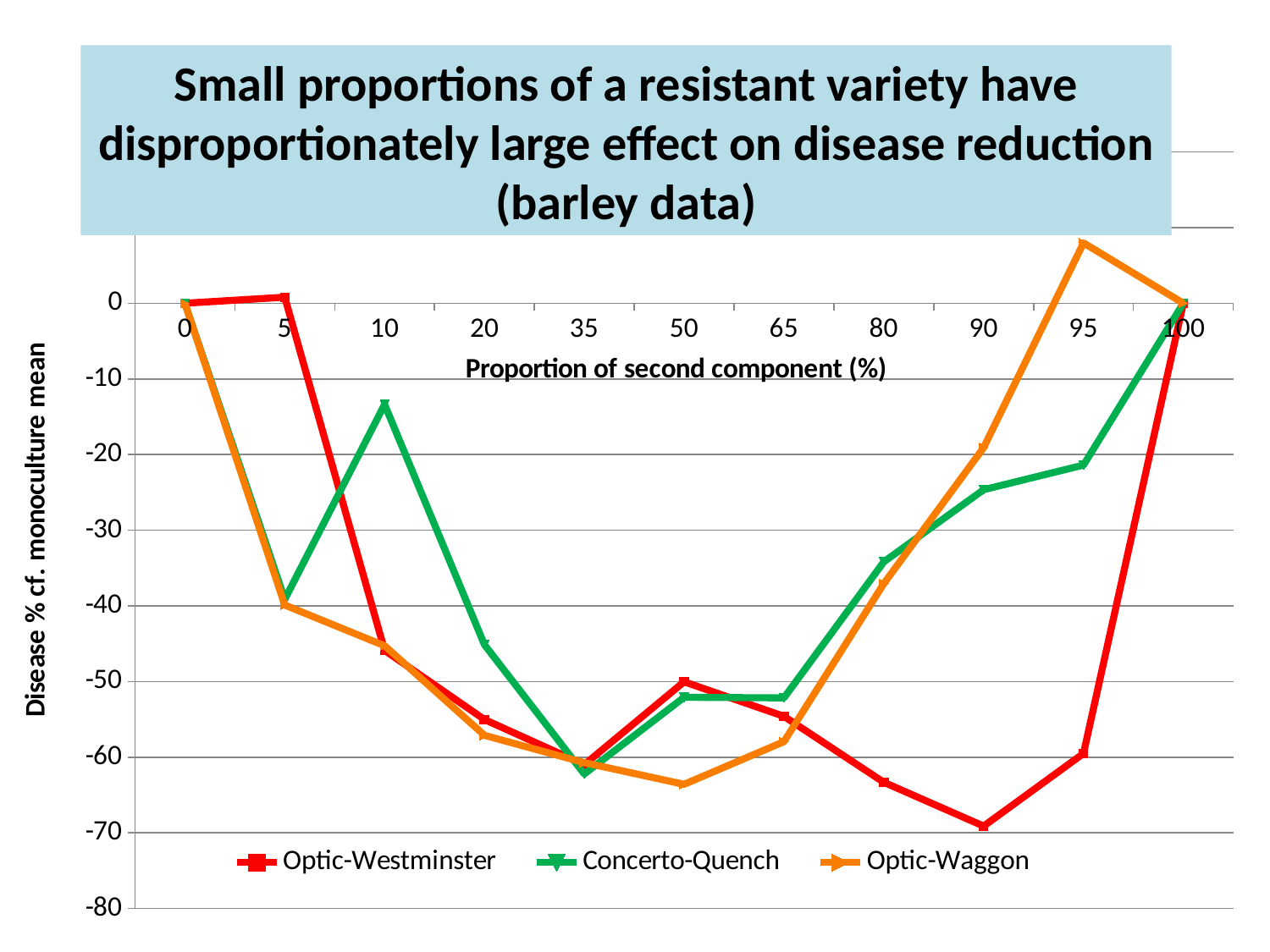
Is the value for Concerto-Quench at a proportion of 10 greater or less than -20? greater Is the value for Optic-Waggon at a proportion of 95 greater or less than 0? greater How many series does the legend list? 3 What is the value for Optic-Westminster at a proportion of 0? 0 At a proportion of 90, which series has the higher value, Optic-Waggon or Optic-Westminster? Optic-Waggon Is the value for Optic-Westminster at a proportion of 90 greater or less than -60? less How many proportion values are marked along the x axis? 11 What is the title of the x axis? Proportion of second component (%) Does the Optic-Waggon line rise or fall between proportions 50 and 95? Rise Which series has the lowest value at a proportion of 90? Optic-Westminster What type of chart is shown on the slide? Line chart What is the value for Concerto-Quench at a proportion of 100? 0